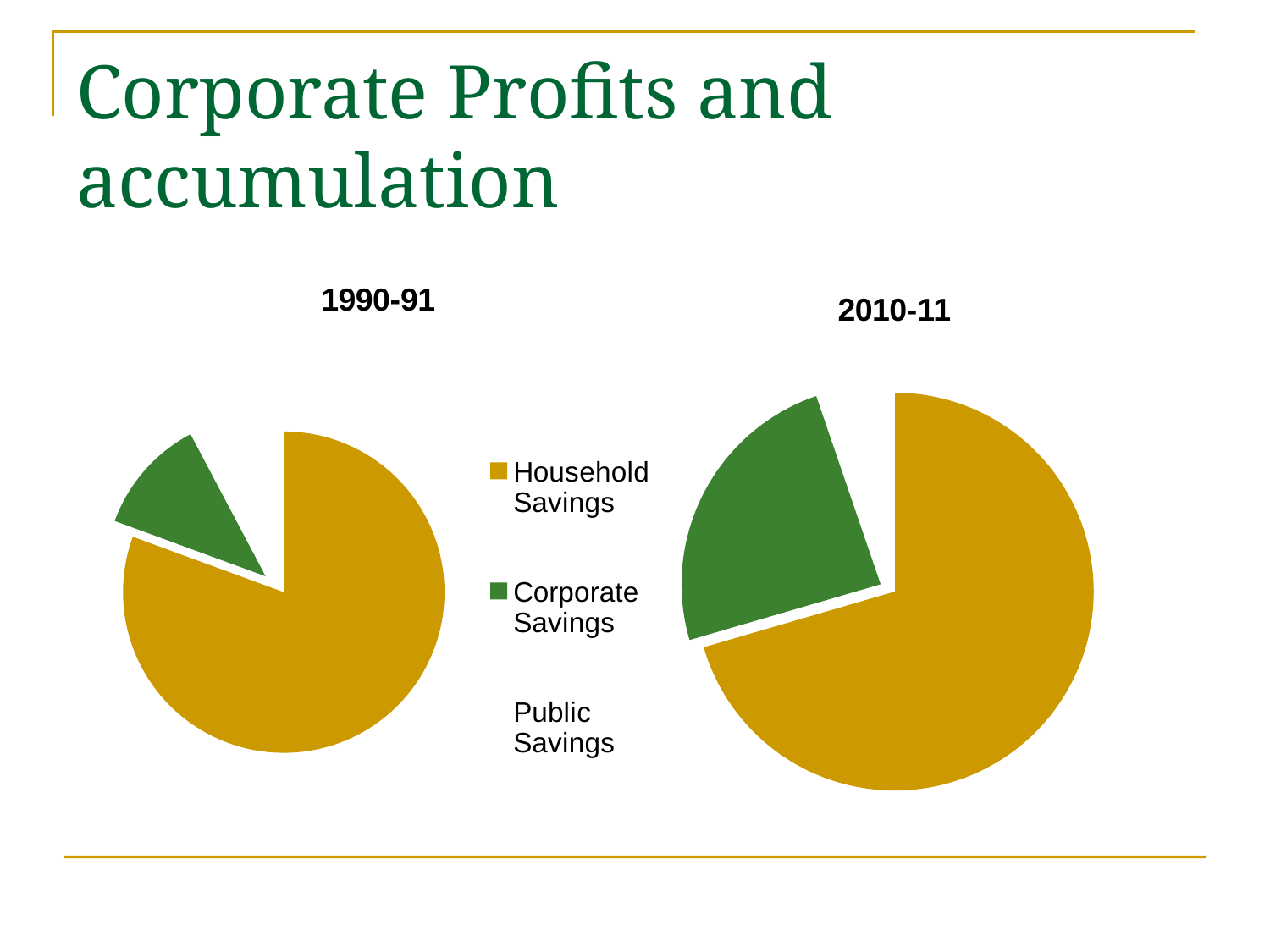
What kind of chart is used for the 1990-91 data? Pie chart Is the Corporate Savings share larger in the 1990-91 pie chart or the 2010-11 pie chart? 2010-11 How many entries does the legend list? 3 In the 2010-11 pie chart, which category has the largest slice? Household Savings In the 2010-11 pie chart, which is larger: Household Savings or Corporate Savings? Household Savings How many pie charts are shown on the slide? 2 In the 1990-91 pie chart, which category has the largest slice? Household Savings What colour represents Household Savings in the pie charts? Gold In the 1990-91 pie chart, is the Household Savings share greater or less than 50%? greater What is the title of the slide? Corporate Profits and accumulation In the 1990-91 pie chart, which is smaller: Household Savings or Corporate Savings? Corporate Savings